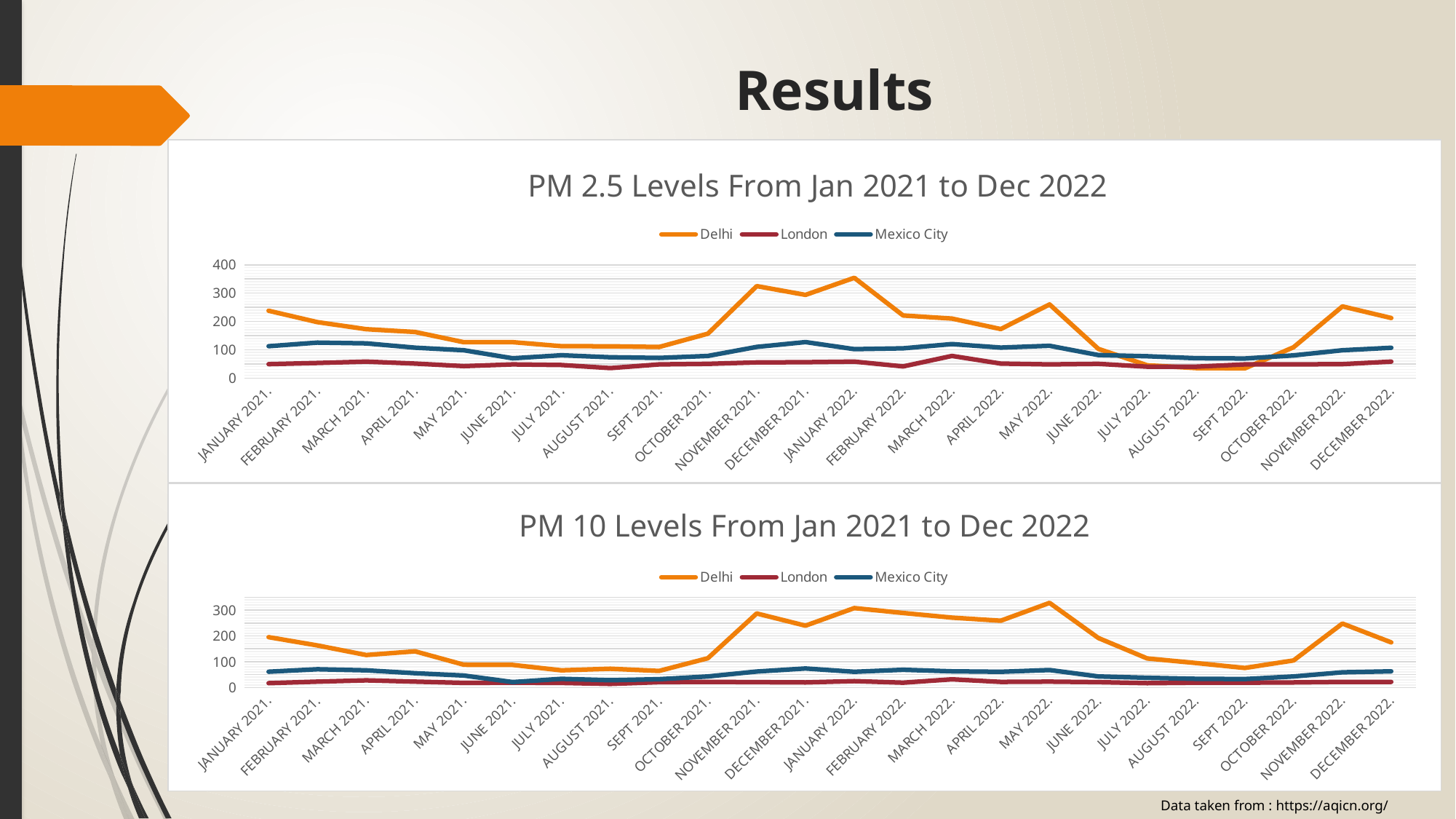
What colour is the Delhi line in the 'PM 10 Levels From Jan 2021 to Dec 2022' chart? Orange In the 'PM 10 Levels From Jan 2021 to Dec 2022' chart, which city has the lowest values overall? London In the 'PM 2.5 Levels From Jan 2021 to Dec 2022' chart, how many months are shown on the x axis? 24 In the 'PM 2.5 Levels From Jan 2021 to Dec 2022' chart, which city has the highest values overall? Delhi In the 'PM 2.5 Levels From Jan 2021 to Dec 2022' chart, which is larger in December 2021: Mexico City or London? Mexico City In the 'PM 2.5 Levels From Jan 2021 to Dec 2022' chart, is the value for Delhi in January 2022 greater or less than 300? greater In the 'PM 2.5 Levels From Jan 2021 to Dec 2022' chart, in which month does Delhi reach its highest value? January 2022 In the 'PM 2.5 Levels From Jan 2021 to Dec 2022' chart, is the value for Delhi in July 2022 greater or less than 100? less In the 'PM 10 Levels From Jan 2021 to Dec 2022' chart, which is larger in January 2021: Delhi or Mexico City? Delhi What kind of chart is the 'PM 2.5 Levels From Jan 2021 to Dec 2022' chart? Line chart How many series does the legend of the 'PM 10 Levels From Jan 2021 to Dec 2022' chart list? 3 In the 'PM 10 Levels From Jan 2021 to Dec 2022' chart, is the value for Delhi in November 2021 greater or less than 200? greater